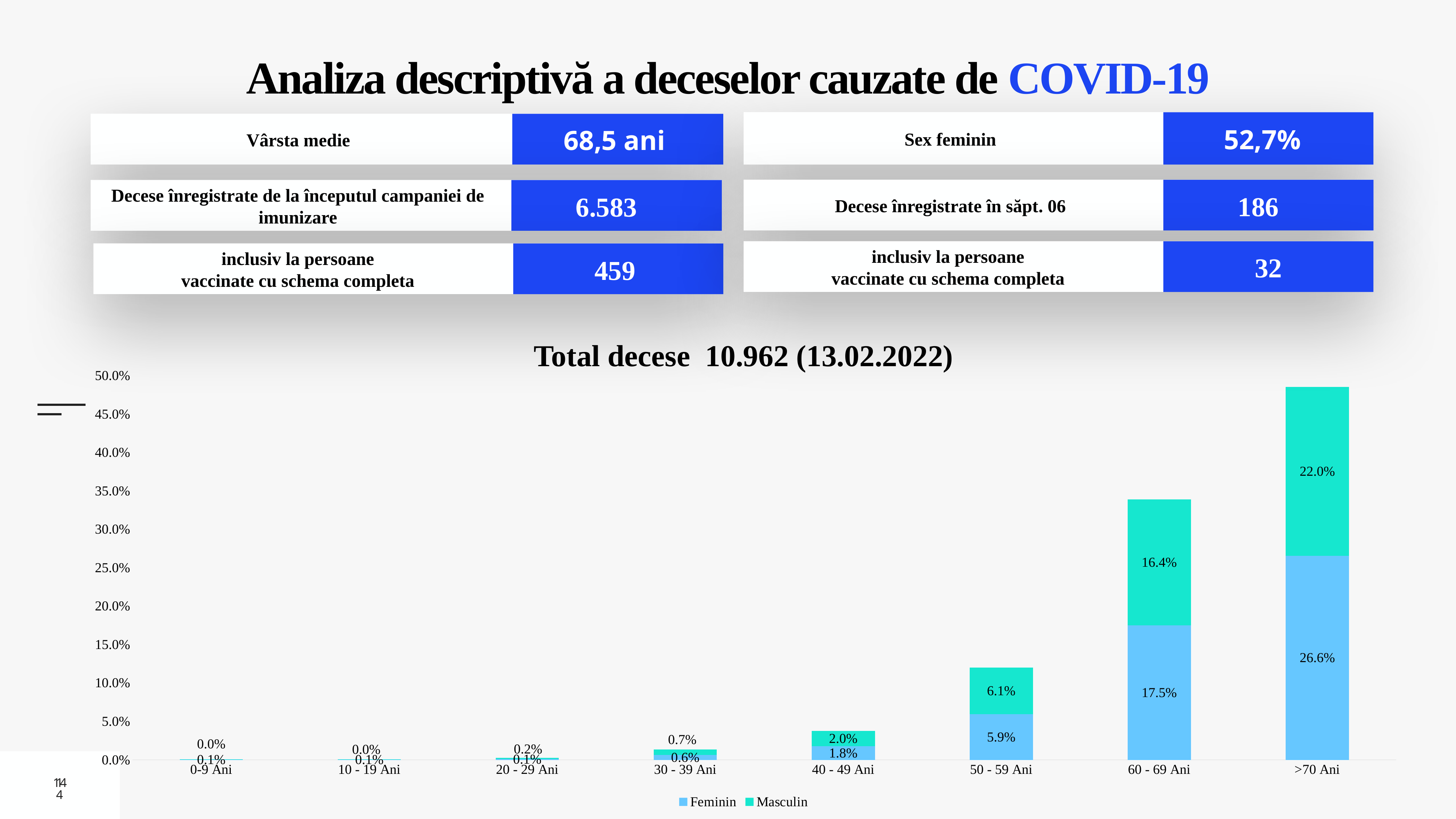
What is the total of the stacked bar for the 50 - 59 Ani age group? 12.0% What is the Feminin value for the >70 Ani age group? 26.6% How many age groups are shown on the x axis of the chart? 8 What is the Feminin value for the 40 - 49 Ani age group? 1.8% Which is larger for the 60 - 69 Ani age group, the Feminin value or the Masculin value? Feminin What kind of chart is shown on the slide? Stacked bar chart What is the difference between the Feminin and Masculin values for the >70 Ani age group? 4.6% Which age group has the highest Masculin value? >70 Ani What is the total of the stacked bar for the 60 - 69 Ani age group? 33.9% What is the Masculin value for the 50 - 59 Ani age group? 6.1% How many series does the chart legend list? 2 What is the Masculin value for the 60 - 69 Ani age group? 16.4%